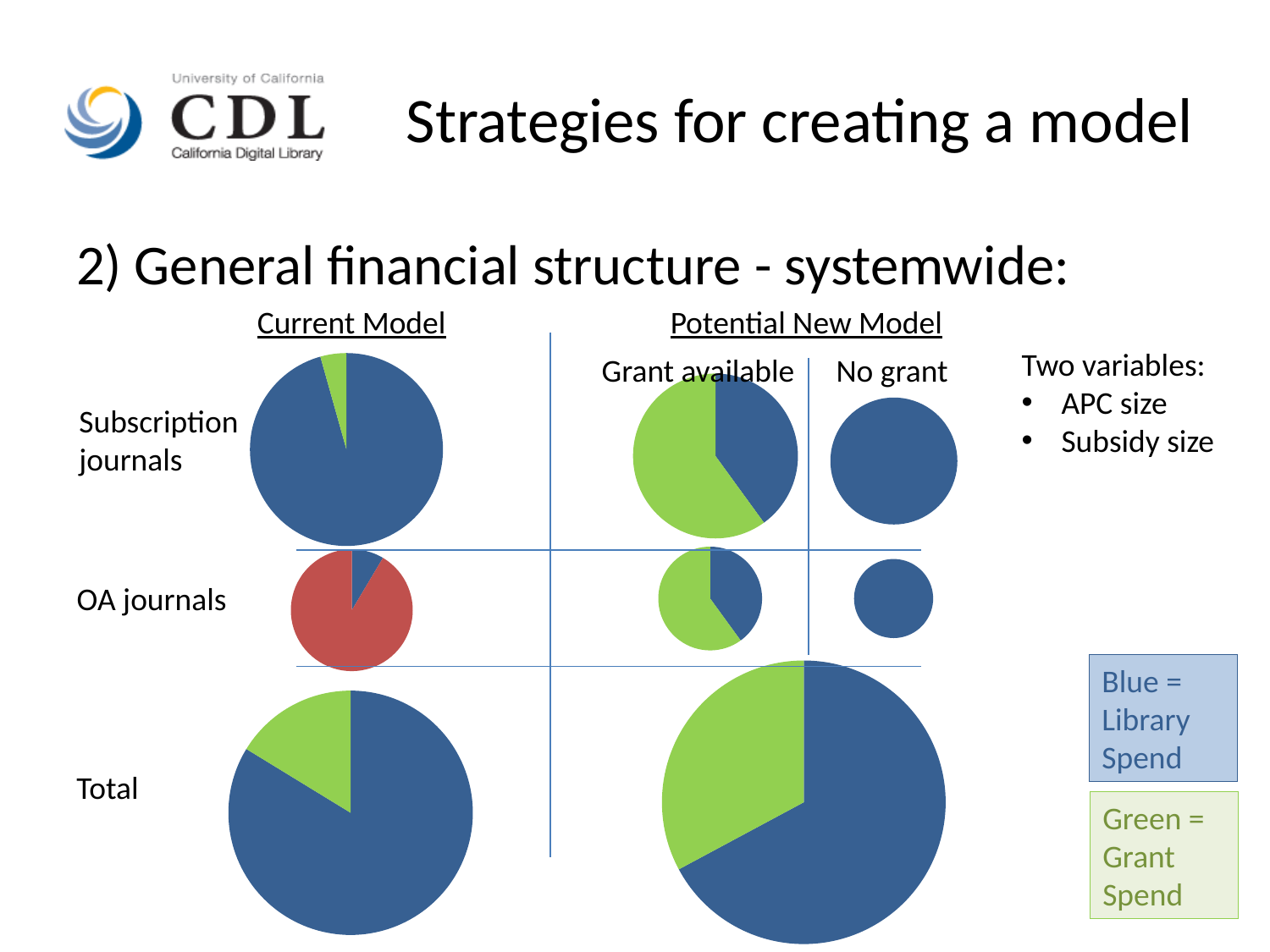
How many row categories (journal types) are shown down the left side of the chart area? 3 In the Potential New Model pie for Total, which slice is larger, blue or green? Blue In the Current Model pie for OA journals, which slice is larger, the red slice or the blue slice? Red What kind of chart is used to show the financial structure on this slide? Pie chart According to the legend boxes, what does the green colour represent? Grant Spend Which pie is larger in size, the Current Model Total pie or the Current Model OA journals pie? Current Model Total pie According to the legend boxes, what does the blue colour represent? Library Spend How many pie charts are shown under the Potential New Model heading? 5 How many pie charts are shown under the Current Model heading? 3